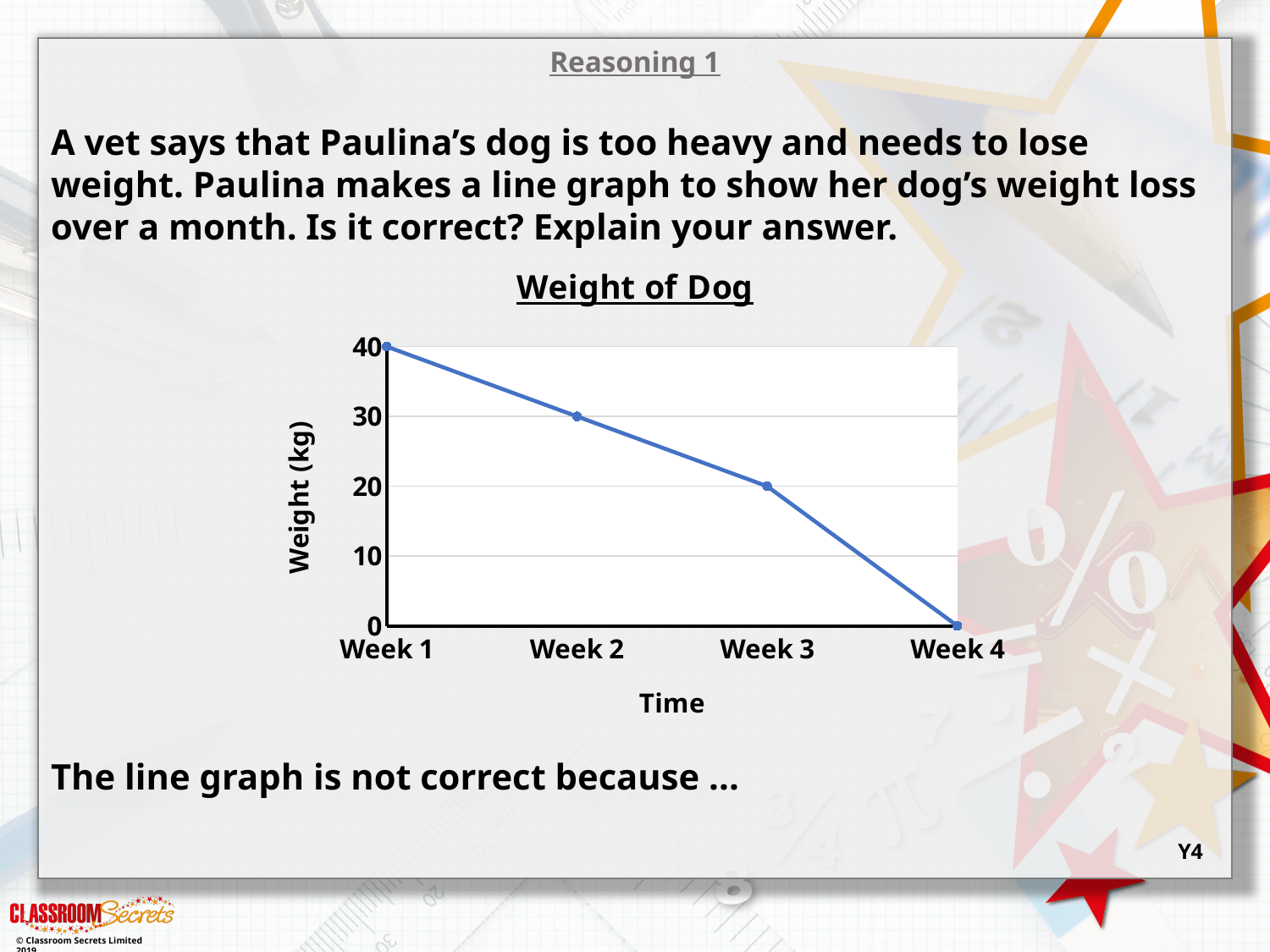
What kind of chart is shown on the slide? line chart In which week is the dog's weight lowest? Week 4 Does the dog's weight rise or fall from Week 1 to Week 4? fall What is the dog's weight in Week 3? 20 What is the label of the vertical axis? Weight (kg) What is the difference in weight between Week 1 and Week 3? 20 In which week is the dog's weight highest? Week 1 What is the dog's weight in Week 1? 40 What is the dog's weight in Week 4? 0 How many weeks are plotted on the chart? 4 What is the title of the chart? Weight of Dog What is the dog's weight in Week 2? 30